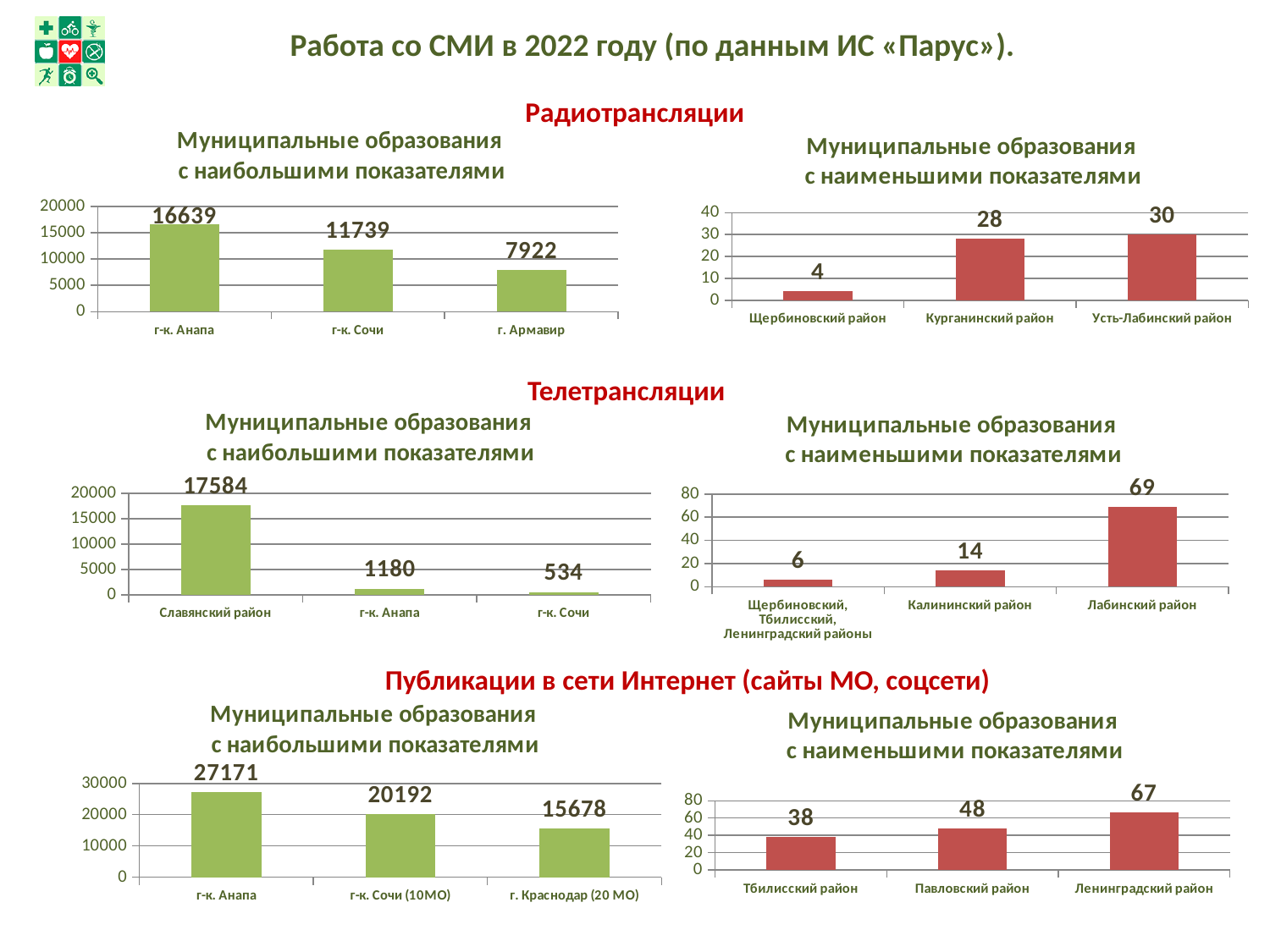
In the 'Телетрансляции' chart for municipalities with the highest indicators (middle left), what is the value for г-к. Сочи? 534 In the 'Телетрансляции' chart for municipalities with the highest indicators (middle left), which category has the highest value? Славянский район In the 'Радиотрансляции' chart for municipalities with the lowest indicators (top right), what is the difference between Усть-Лабинский район and Курганинский район? 2 In the 'Радиотрансляции' chart for municipalities with the highest indicators (top left), what is the value for г-к. Анапа? 16639 In the 'Радиотрансляции' chart for municipalities with the lowest indicators (top right), which category has the lowest value? Щербиновский район In the 'Телетрансляции' chart for municipalities with the lowest indicators (middle right), what is the value for Калининский район? 14 In the 'Телетрансляции' chart for municipalities with the lowest indicators (middle right), is the value for Лабинский район greater or less than 60? greater How many categories are shown in the 'Публикации в сети Интернет' chart for municipalities with the lowest indicators (bottom right)? 3 In the 'Публикации в сети Интернет' chart for municipalities with the highest indicators (bottom left), what is the value for г. Краснодар (20 МО)? 15678 In the 'Публикации в сети Интернет' chart for municipalities with the lowest indicators (bottom right), which is larger: Павловский район or Тбилисский район? Павловский район In the 'Публикации в сети Интернет' chart for municipalities with the highest indicators (bottom left), what is the difference between г-к. Анапа and г-к. Сочи (10МО)? 6979 What type of chart is the 'Радиотрансляции' chart for municipalities with the highest indicators (top left)? bar chart